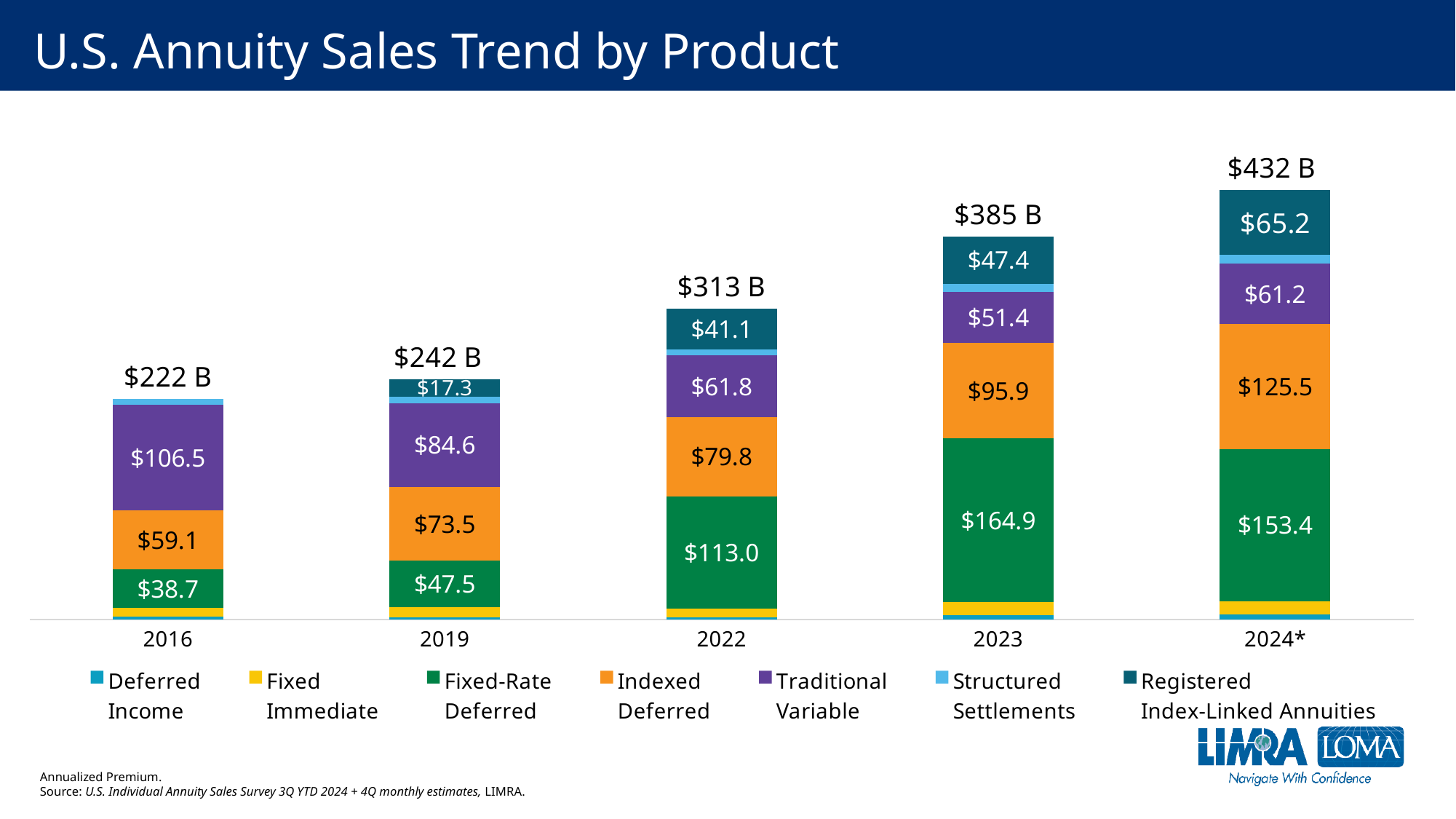
What is the Indexed Deferred value for 2022? $79.8 What is the Fixed-Rate Deferred value for 2023? $164.9 What is the difference between the Fixed-Rate Deferred values for 2023 and 2024*? $11.5 What is the Registered Index-Linked Annuities value for 2019? $17.3 Do the total annuity sales rise or fall from 2016 to 2024*? rise How many series does the legend list? 7 Which is larger, the Traditional Variable value in 2019 or in 2022? 2019 Which year has the lowest total annuity sales? 2016 Which year has the highest total annuity sales? 2024* How many years are shown on the x axis? 5 What is the Traditional Variable value for 2016? $106.5 What is the total annuity sales value shown for 2024*? $432 B